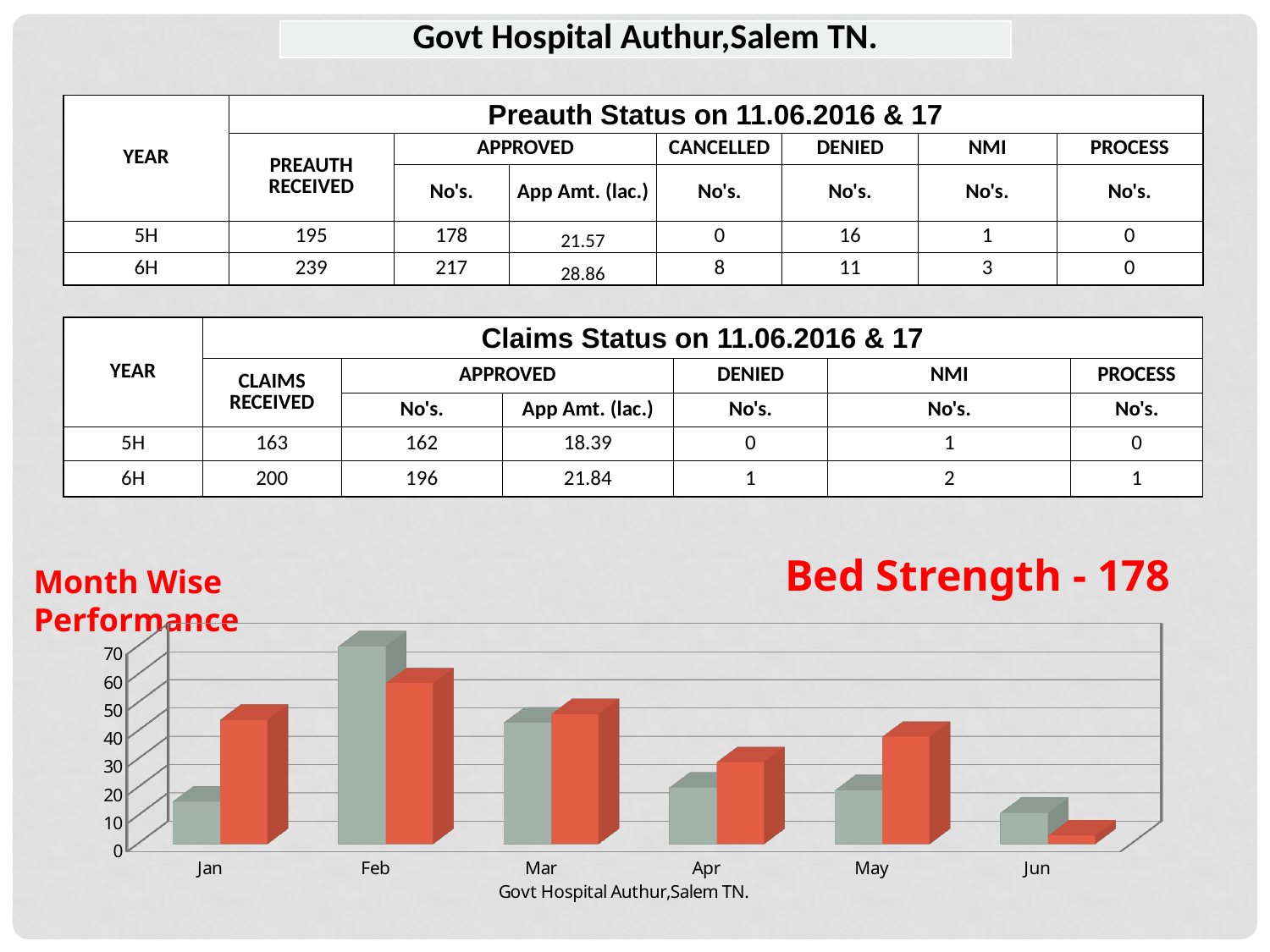
In the Month Wise Performance chart, which month has the shortest red bar? Jun In the Month Wise Performance chart, is the grey bar for Feb greater or less than 60? greater In the Month Wise Performance chart, is the red bar for Jan greater or less than 30? greater What is the heading written in red above the bar chart on the left? Month Wise Performance How many months are shown on the x axis of the Month Wise Performance chart? 6 In the Month Wise Performance chart, is the red bar for Jun greater or less than 10? less In the Month Wise Performance chart, which bar is taller for Feb, the grey bar or the red bar? the grey bar In the Month Wise Performance chart, which bar is taller for Jan, the grey bar or the red bar? the red bar What label appears below the x axis of the Month Wise Performance chart? Govt Hospital Authur,Salem TN. In the Month Wise Performance chart, which month has the tallest grey bar? Feb What kind of chart is shown at the bottom of the slide? bar chart